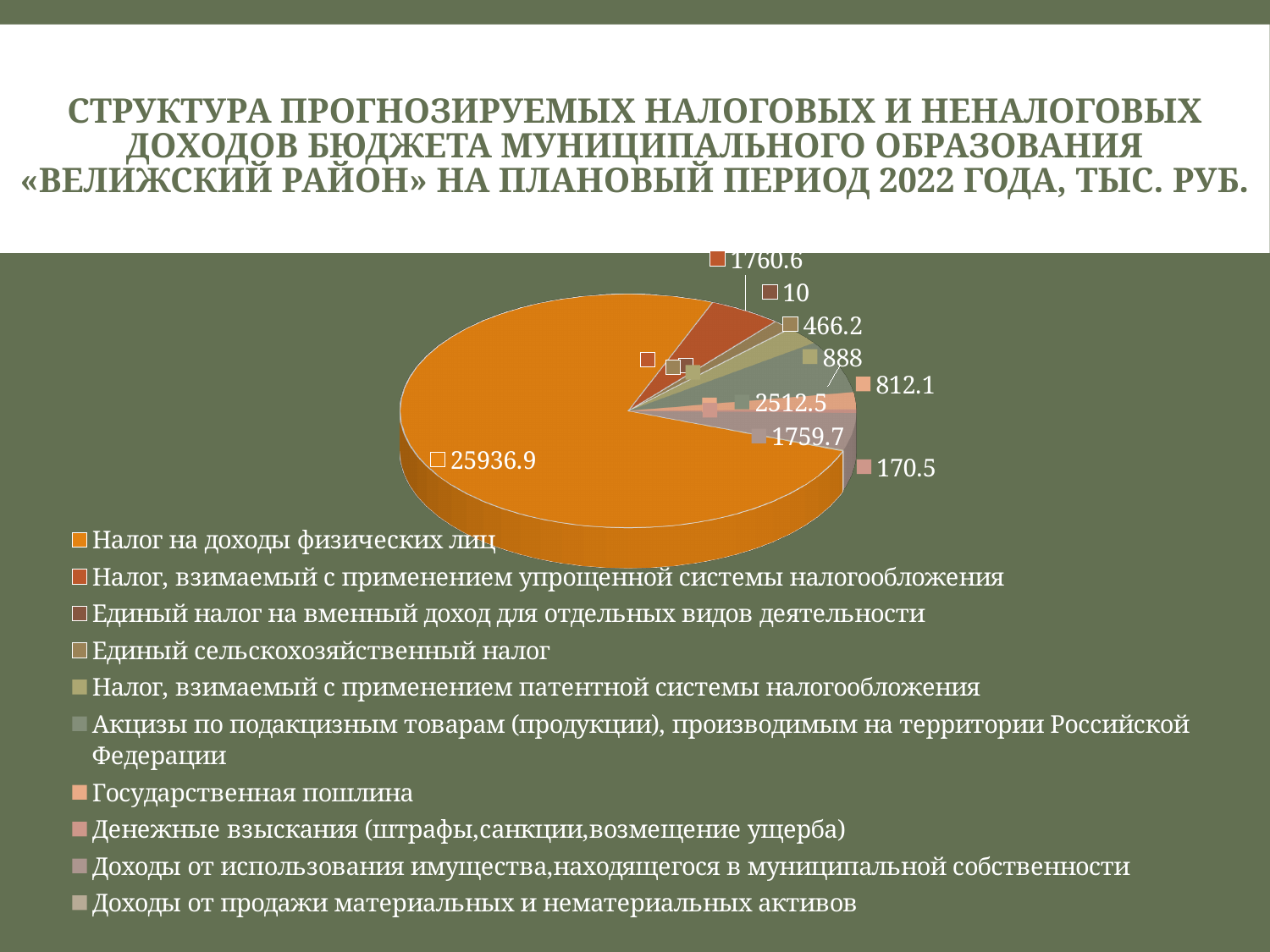
What value is shown for 'Налог, взимаемый с применением упрощенной системы налогообложения'? 1760.6 Is the value for 'Налог на доходы физических лиц' greater or less than 20000? greater What is the difference between the value for 'Акцизы по подакцизным товарам' (2512.5) and the value for 'Налог, взимаемый с применением упрощенной системы налогообложения' (1760.6)? 751.9 How many categories does the legend list? 10 Which category has the largest slice of the pie? Налог на доходы физических лиц Which category is listed first in the legend? Налог на доходы физических лиц In what units are the values on the chart expressed, according to the slide title? тыс. руб. What is the value shown for the largest slice of the pie? 25936.9 Which is larger: the value for 'Налог на доходы физических лиц' or the value for 'Налог, взимаемый с применением упрощенной системы налогообложения'? Налог на доходы физических лиц What kind of chart is shown on the slide? Pie chart What value is shown for 'Акцизы по подакцизным товарам (продукции), производимым на территории Российской Федерации'? 2512.5